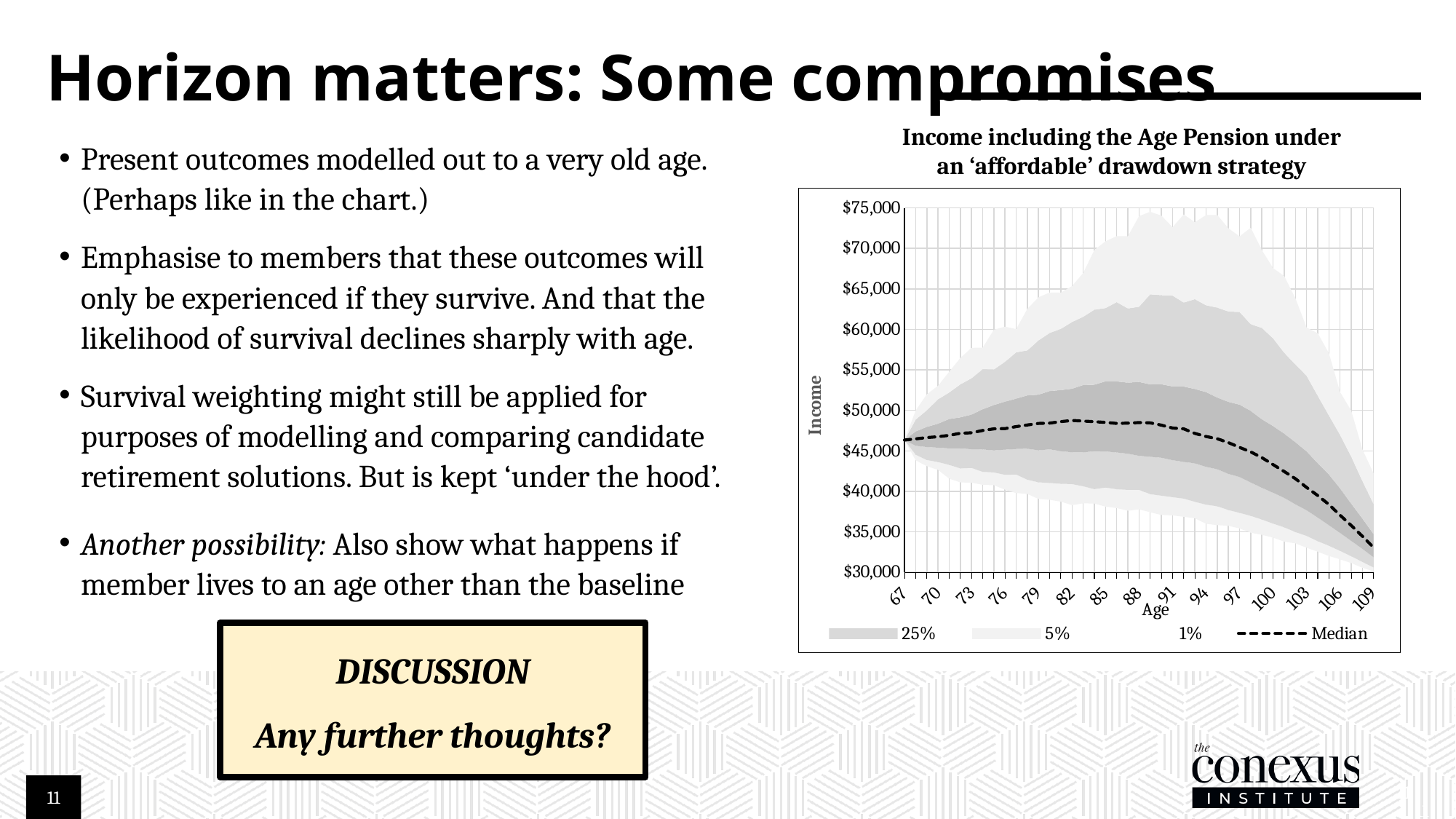
What is the highest value shown on the chart's vertical axis? $75,000 How many entries does the chart's legend list? 4 What is the first age shown on the chart's horizontal axis? 67 Is the Median value at age 109 greater or less than $35,000? less Is the Median value at age 82 greater or less than $50,000? less What label is shown on the vertical axis of the chart? Income What is the last age shown on the chart's horizontal axis? 109 Which legend entry is drawn as a dashed line in the chart? Median What is the lowest value shown on the chart's vertical axis? $30,000 What is the title of the chart on the slide? Income including the Age Pension under an 'affordable' drawdown strategy How many age labels are shown along the chart's horizontal axis? 15 Is the Median value at age 109 higher or lower than the Median value at age 67? lower